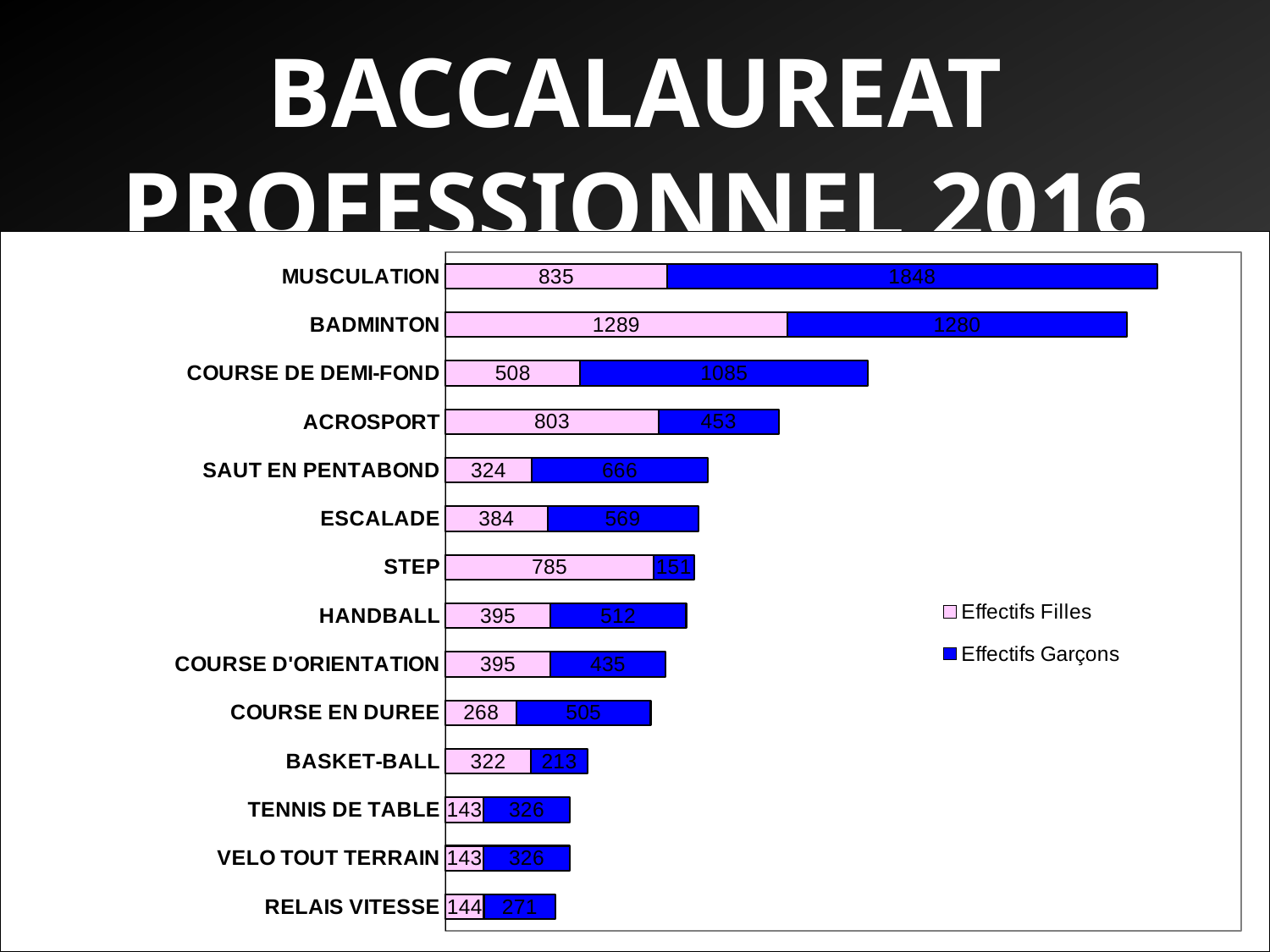
How many categories are shown in the chart? 14 How many series does the legend list? 2 What is the Effectifs Garçons value for COURSE DE DEMI-FOND? 1085 Which category has the highest Effectifs Filles value? BADMINTON What is the total of the stacked bar for BADMINTON? 2569 What is the difference between the Effectifs Garçons and Effectifs Filles values for MUSCULATION? 1013 What kind of chart is shown on the slide? Stacked bar chart What is the Effectifs Garçons value for STEP? 151 Which category has the lowest Effectifs Garçons value? STEP Which series is shown in blue in the legend? Effectifs Garçons Which is larger for ACROSPORT: Effectifs Filles or Effectifs Garçons? Effectifs Filles What is the Effectifs Filles value for MUSCULATION? 835